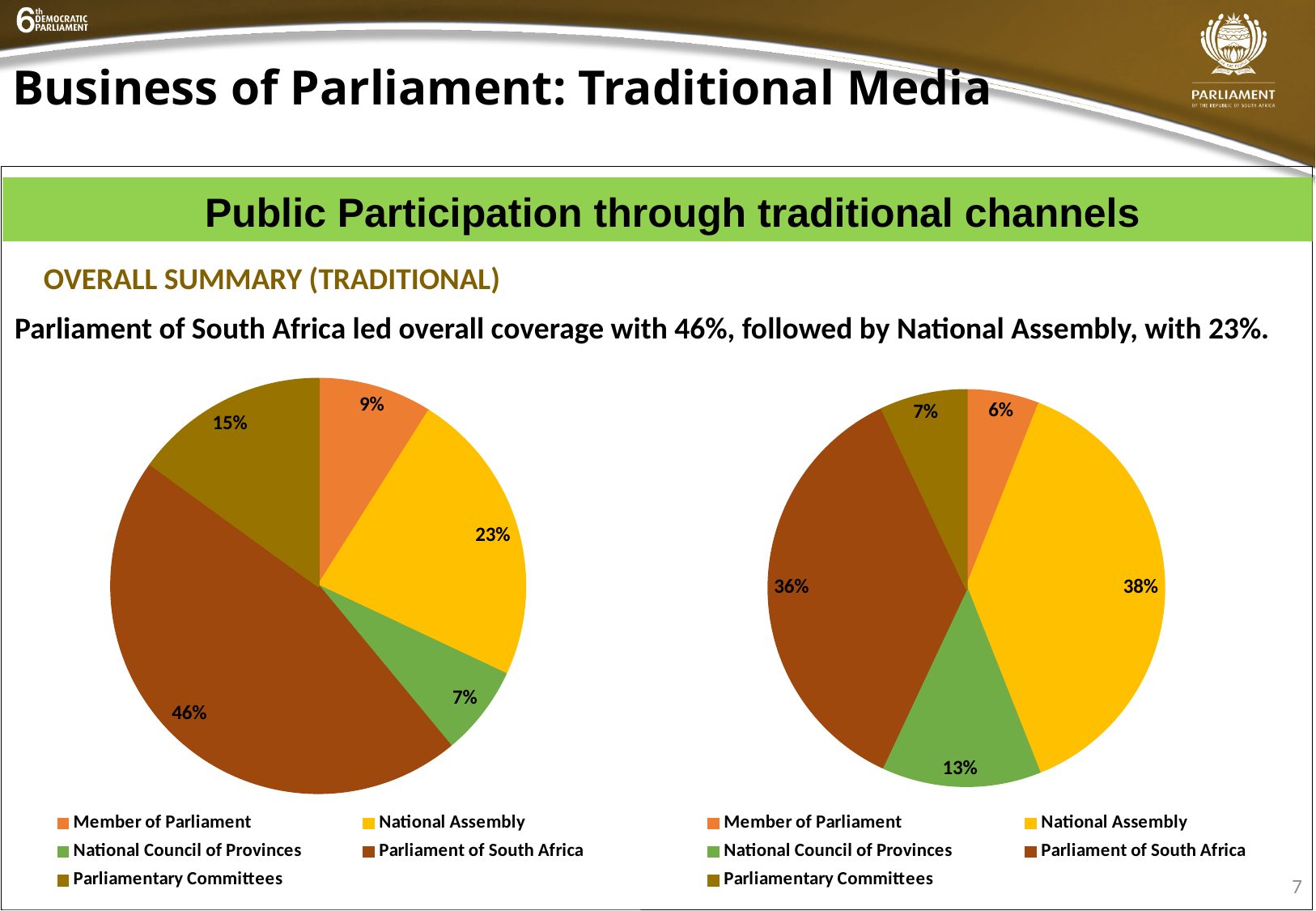
In the right pie chart, which category has the smallest share? Member of Parliament In the right pie chart, what share does National Council of Provinces have? 13% In the left pie chart, what is the difference between the shares of Parliament of South Africa and National Assembly? 23 percentage points In the right pie chart, what share does National Assembly have? 38% In the left pie chart, what share does National Assembly have? 23% In the left pie chart, which colour represents Parliamentary Committees? Dark olive/brown In the left pie chart, which category has the largest share? Parliament of South Africa In the left pie chart, which category has the smallest share? National Council of Provinces In the left pie chart, what share does Parliament of South Africa have? 46% How many categories does the legend of the right pie chart list? 5 In the right pie chart, which is larger: the share for Parliament of South Africa or the share for Parliamentary Committees? Parliament of South Africa What type of chart is the left chart? Pie chart